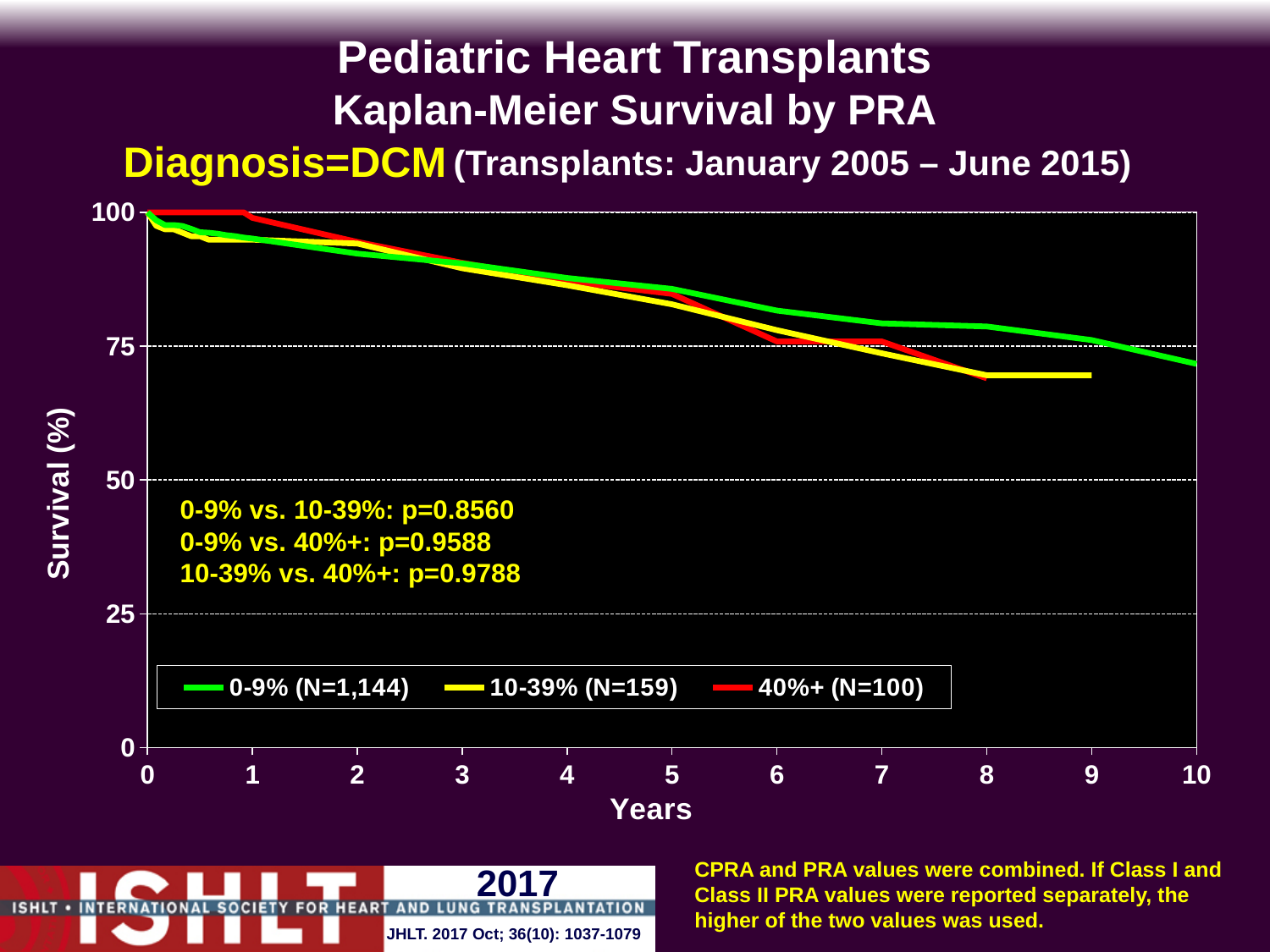
Is the survival value for the 0-9% group at year 10 greater or less than 75? less Is the survival value for the 10-39% group at year 9 greater or less than 75? less How many series does the legend list? 3 Which group has the highest survival at year 8? 0-9% At year 8, which group has higher survival: 0-9% or 10-39%? 0-9% What p-value is shown for 0-9% vs. 40%+? p=0.9588 What kind of chart is shown on the slide? line chart Is the survival value for the 40%+ group at year 5 greater or less than 75? greater Do the survival curves rise or fall as years increase? fall Which group's curve extends the furthest along the x axis? 0-9% What is the N for the 0-9% group shown in the legend? N=1,144